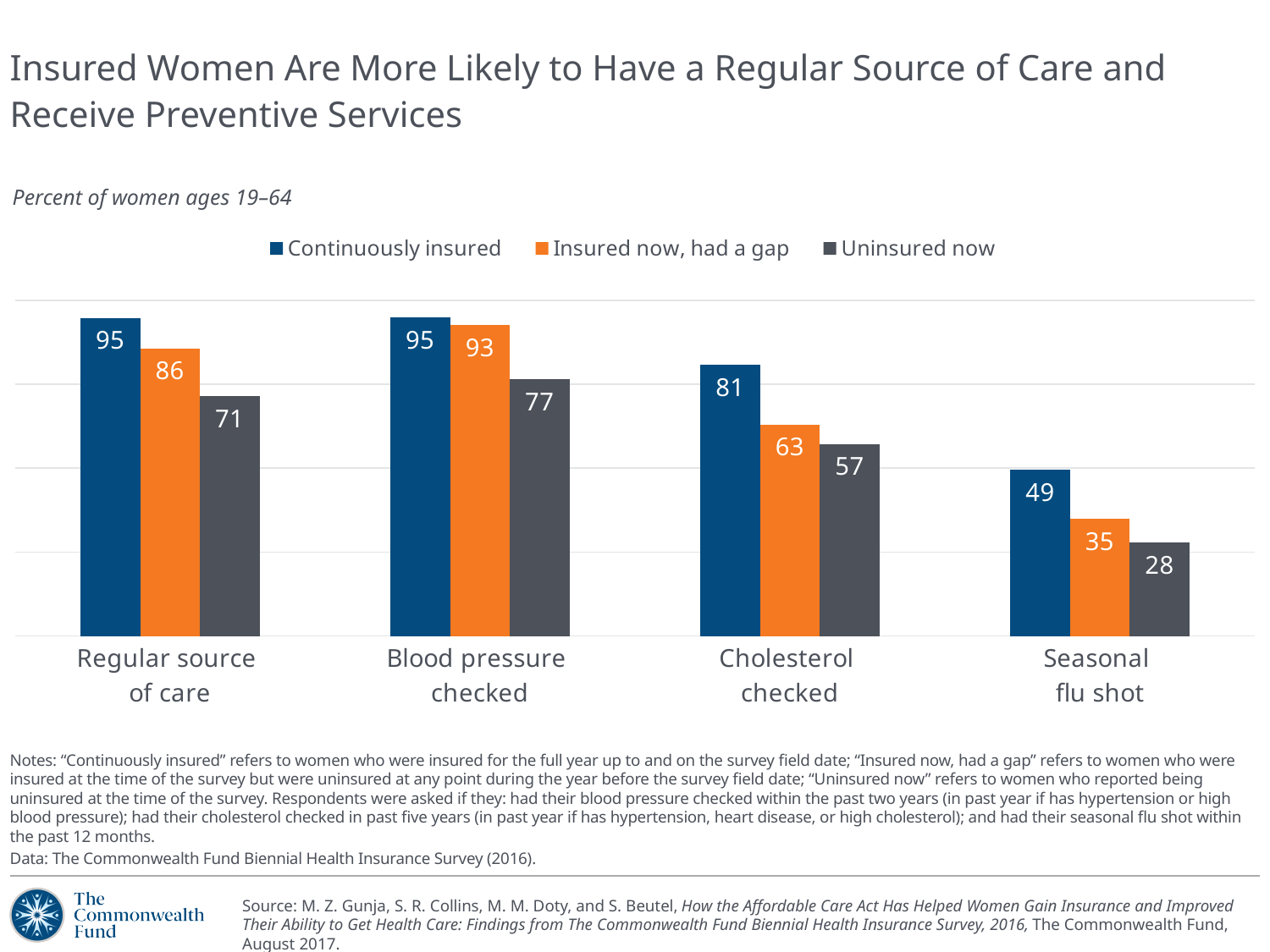
Which colour represents 'Uninsured now' in the chart? Dark gray How many categories are shown on the x axis? 4 What is the difference between continuously insured and uninsured now women for regular source of care? 24 Which is larger: the value for 'Insured now, had a gap' for blood pressure checked or for cholesterol checked? Blood pressure checked What is the value for 'Insured now, had a gap' women for cholesterol checked? 63 Which group has the highest value for blood pressure checked? Continuously insured What is the value for 'Uninsured now' women for seasonal flu shot? 28 What is the difference between 'Insured now, had a gap' and 'Uninsured now' for seasonal flu shot? 7 Which category has the lowest value for continuously insured women? Seasonal flu shot What kind of chart is shown on the slide? Bar chart What percent of continuously insured women have a regular source of care? 95 How many series does the legend list? 3